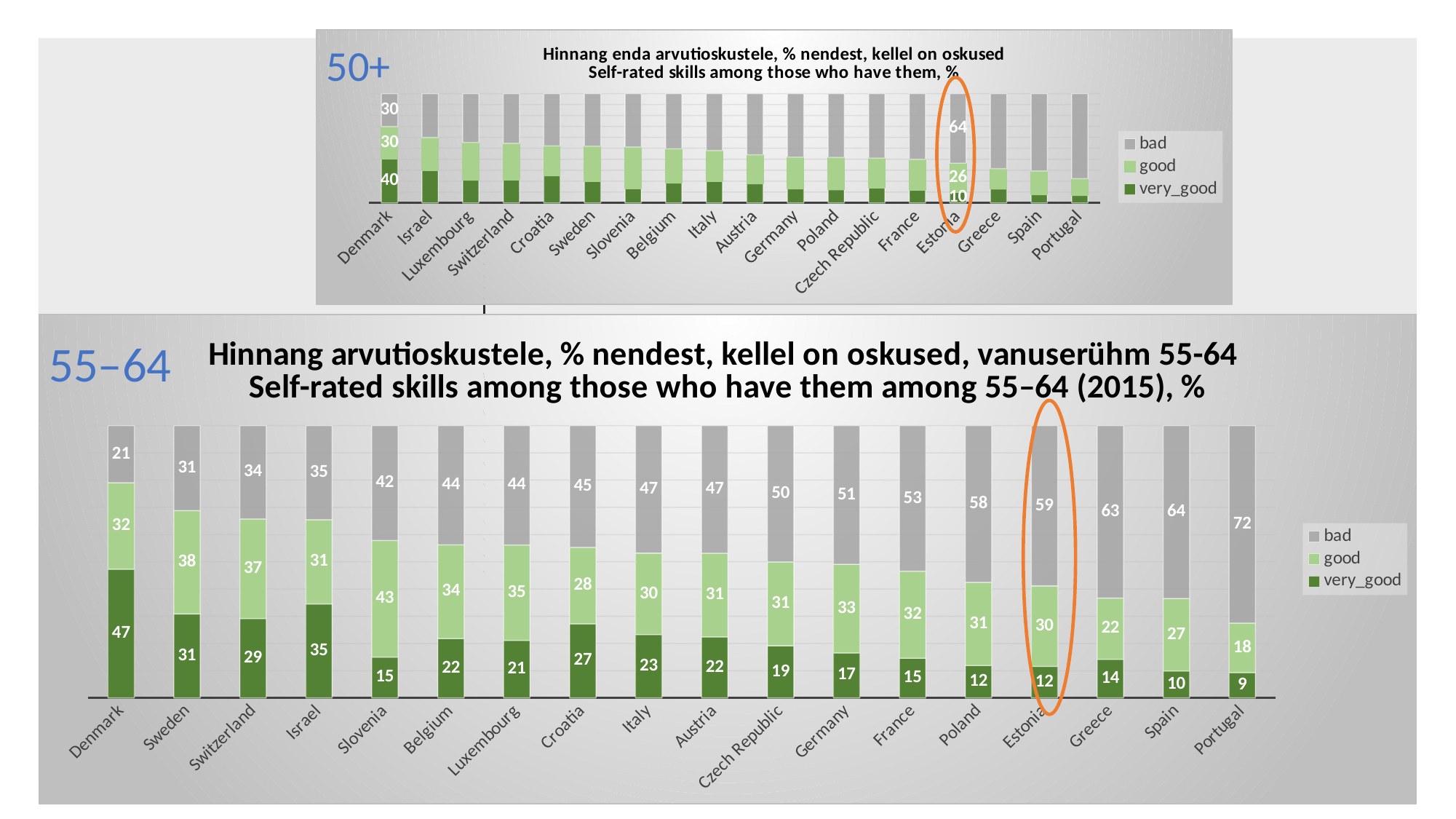
How many countries are shown in the bottom chart (55–64)? 18 In the top chart (50+), what is the 'bad' value for Estonia? 64 In the bottom chart (55–64), what is the difference between the 'bad' values for Estonia and Denmark? 38 In the bottom chart (55–64), which country has the highest 'bad' value? Portugal In the bottom chart (55–64), what is the 'very_good' value for Denmark? 47 How many series does the legend of the top chart (50+) list? 3 In the top chart (50+), what is the 'very_good' value for Denmark? 40 What kind of chart is the bottom chart (55–64)? Stacked bar chart In the bottom chart (55–64), what is the 'good' value for Estonia? 30 In the bottom chart (55–64), which country has the lowest 'very_good' value? Portugal In the bottom chart (55–64), which is larger: the 'good' value for Slovenia or the 'good' value for Sweden? Slovenia In the bottom chart (55–64), what is the 'bad' value for Portugal? 72